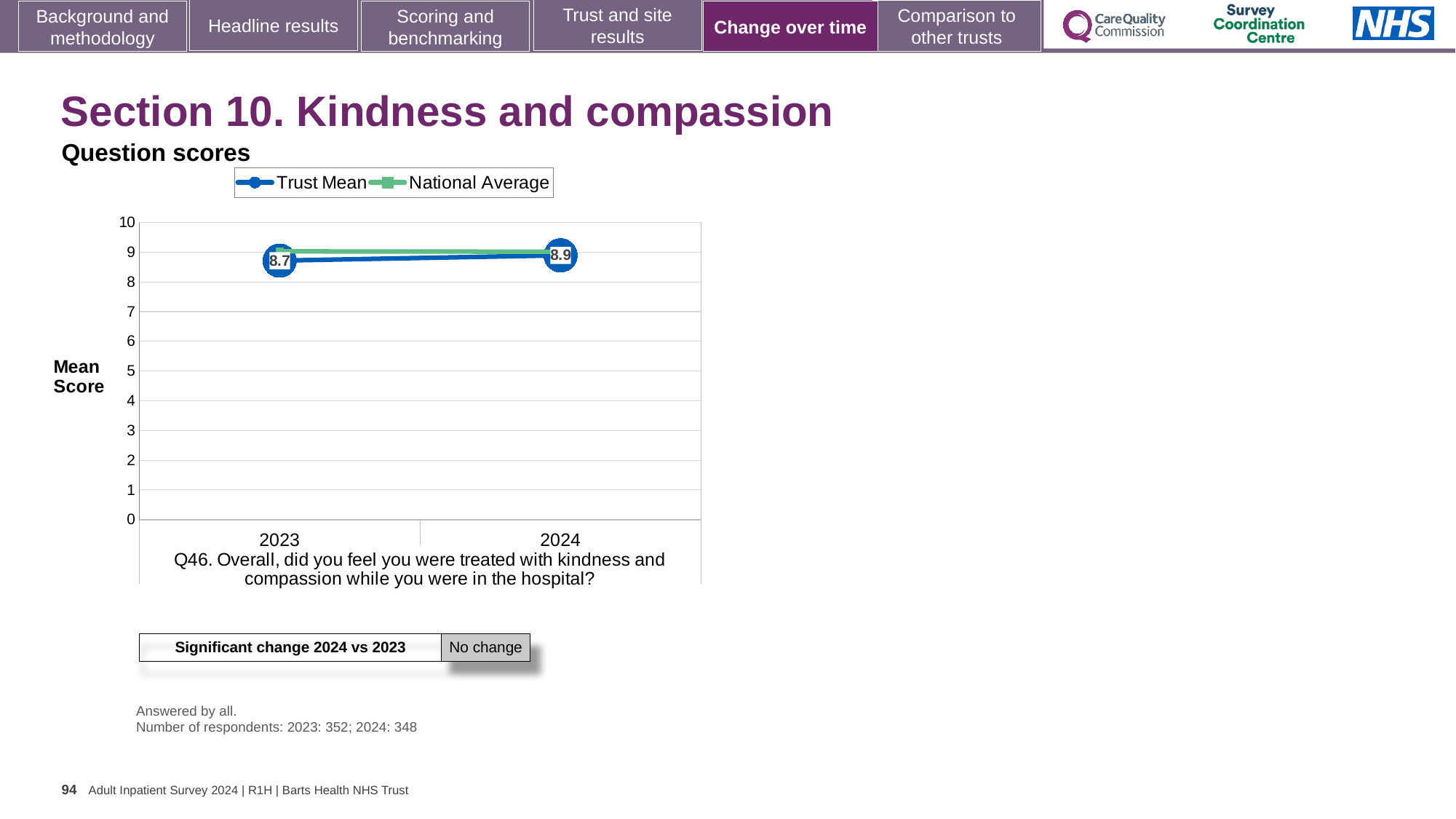
Is the National Average value for 2024 greater or less than 8? greater How many series does the legend list? 2 Which year has the lowest Trust Mean score? 2023 By how much did the Trust Mean change from 2023 to 2024? 0.2 What is the label on the y axis of the chart? Mean Score Which year has the higher Trust Mean score, 2023 or 2024? 2024 What is the Trust Mean score for 2024? 8.9 What is the Trust Mean score for 2023? 8.7 Does the Trust Mean rise or fall from 2023 to 2024? rise What are the two series named in the legend? Trust Mean and National Average How many years are plotted on the x axis? 2 What kind of chart is shown on the slide? line chart